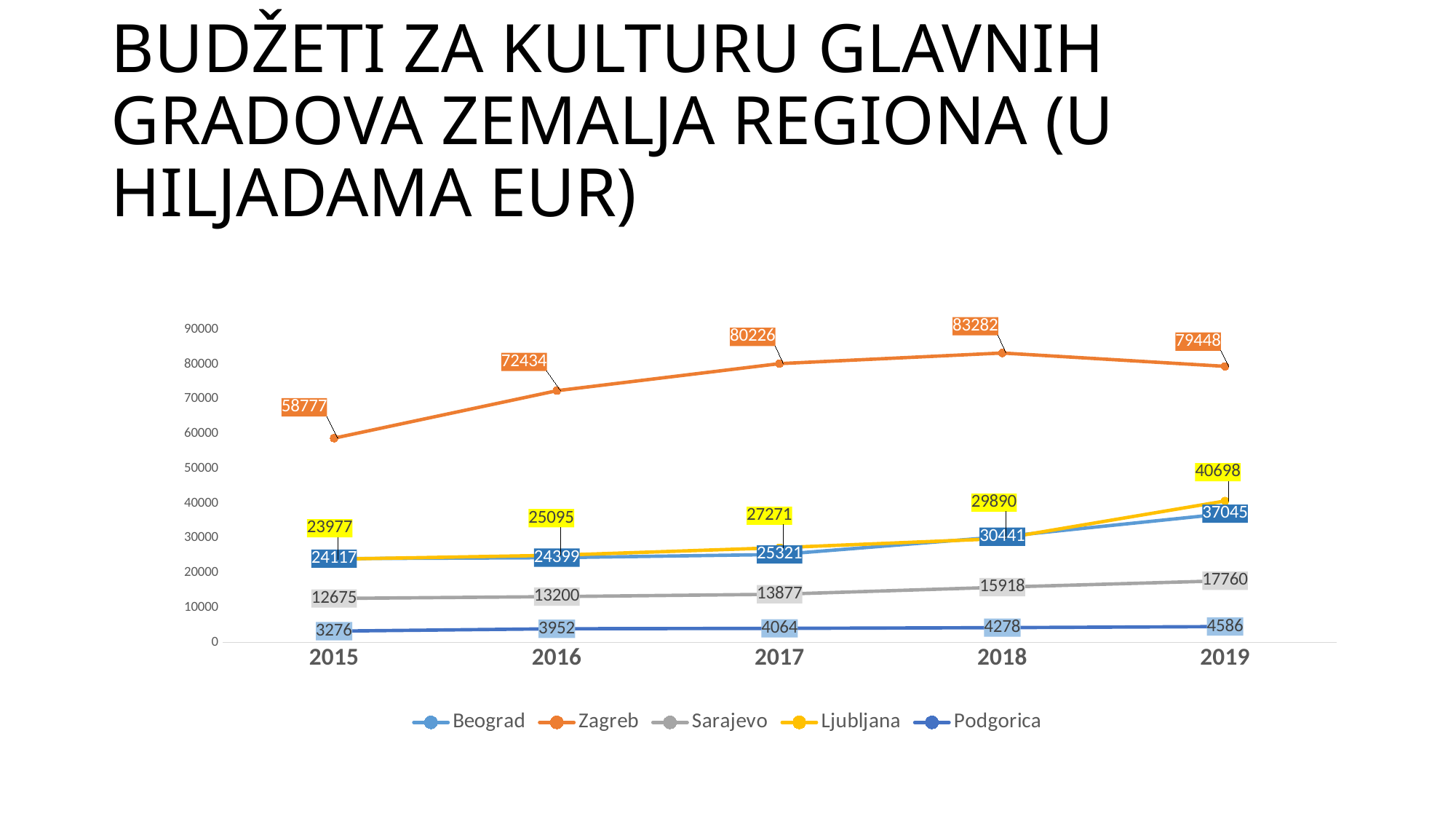
What is the value for Ljubljana in 2019? 40698 What is the value for Podgorica in 2015? 3276 How many years are shown on the x axis? 5 Which is larger in 2019, the value for Beograd or the value for Ljubljana? Ljubljana How many series does the legend list? 5 Which city has the lowest value in 2019? Podgorica What is the value for Zagreb in 2018? 83282 What is the difference between Zagreb's values in 2016 and 2015? 13657 Does Sarajevo's value rise or fall from 2015 to 2019? rise In which year was Zagreb's value highest? 2018 What is the value for Sarajevo in 2017? 13877 What type of chart is shown on the slide? line chart